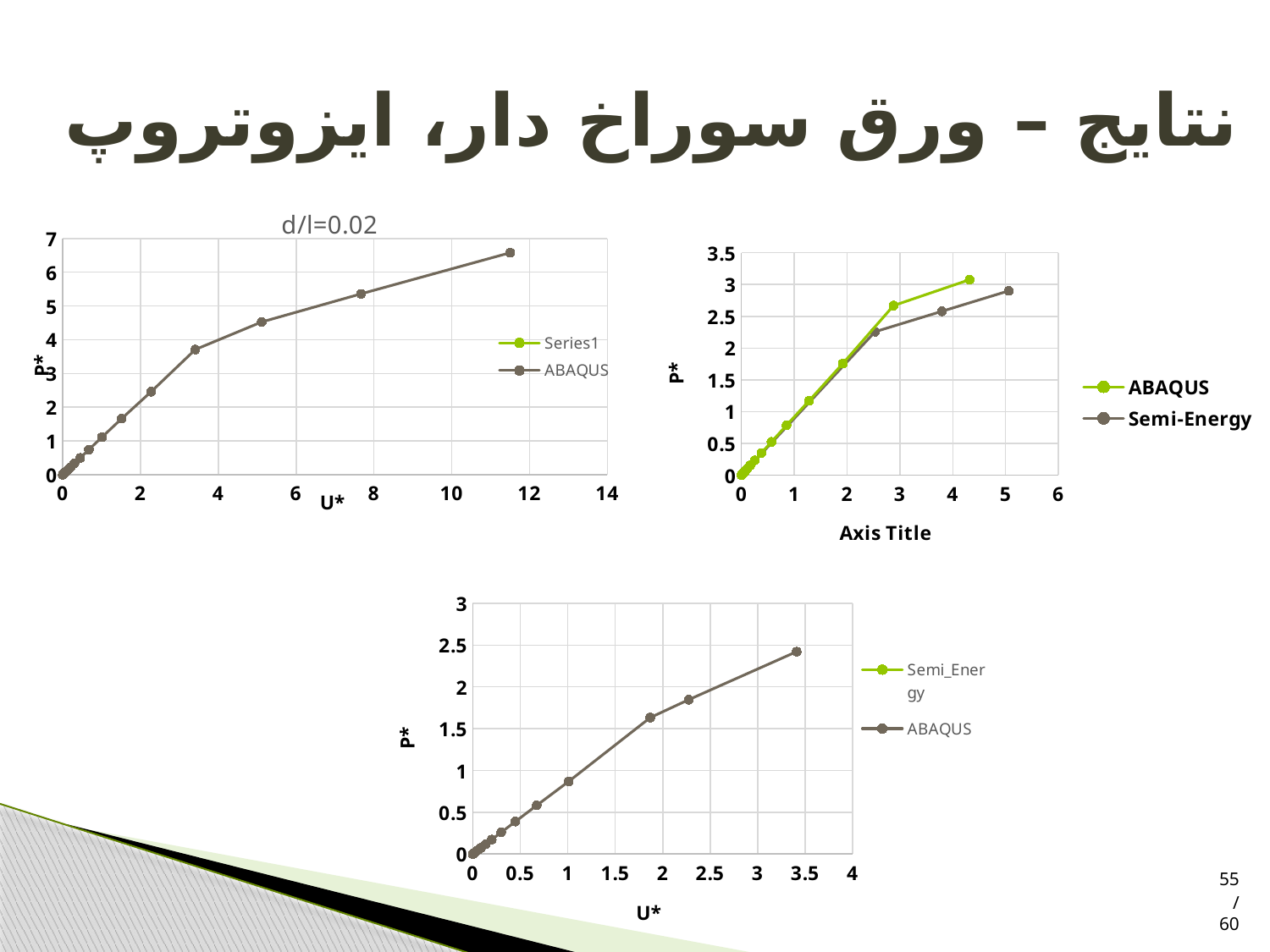
How many series does the legend of the bottom chart list? 2 What is the title of the top-left chart? d/l=0.02 What kind of chart is the top-left chart titled d/l=0.02? line chart In the top-right chart, which two series does the legend list? ABAQUS and Semi-Energy In the top-right chart, is the P* value of the last Semi-Energy point greater or less than 3? less In the top-left chart (d/l=0.02), is the P* value of the point near U* = 8 greater or less than 5? greater In the top-right chart, do the P* values rise or fall as the x-axis value increases? rise In the bottom chart, is the P* value of the last (rightmost) point greater or less than 2.5? less How many series does the legend of the top-left chart (d/l=0.02) list? 2 In the top-left chart (d/l=0.02), do the P* values rise or fall as U* increases? rise